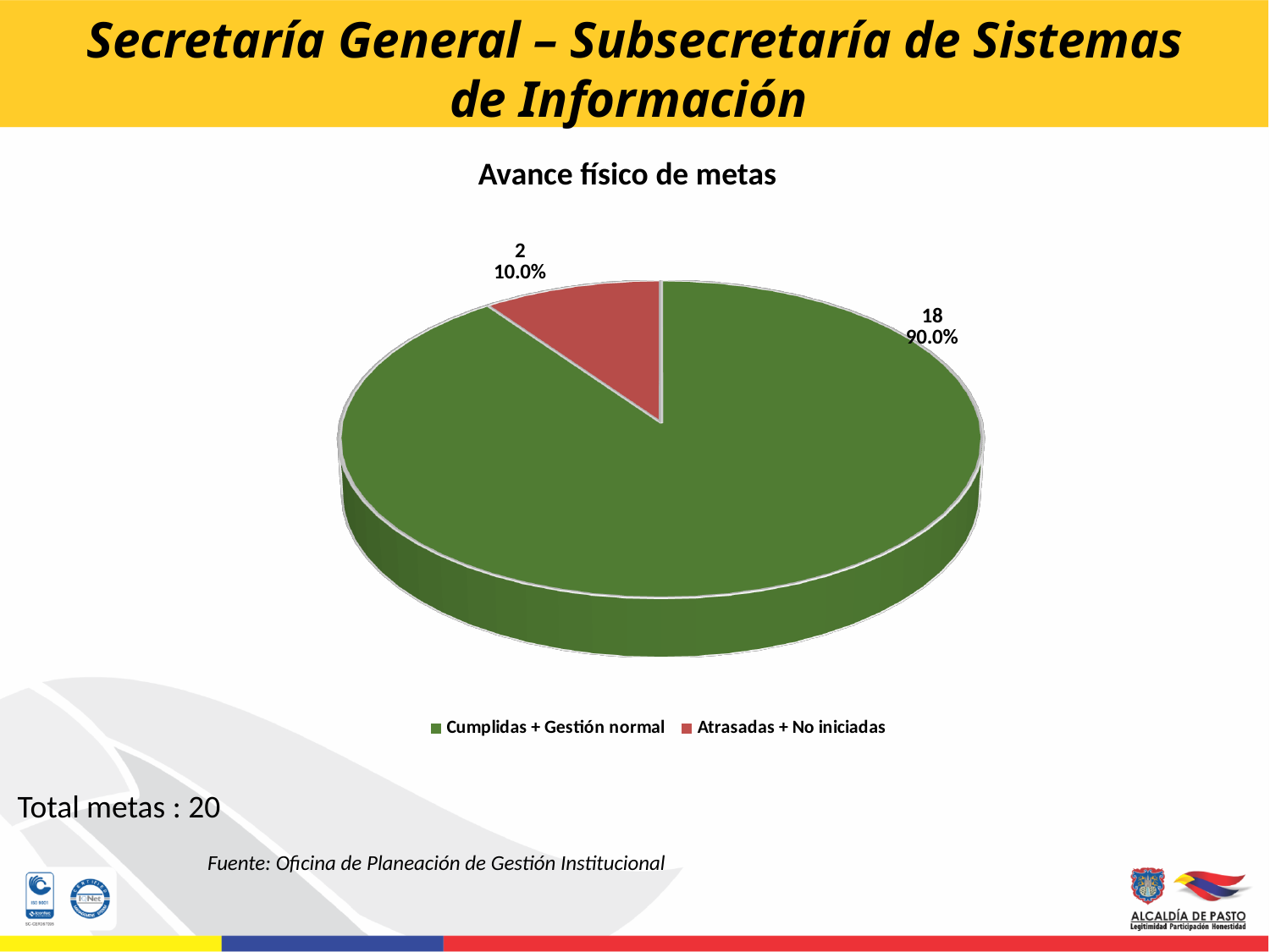
How many entries does the legend list? 2 What is the title of the chart? Avance físico de metas What type of chart is shown on the slide? Pie chart What is the difference between the values for Cumplidas + Gestión normal and Atrasadas + No iniciadas? 16 What share of the pie does Atrasadas + No iniciadas represent? 10.0% What is the value for Atrasadas + No iniciadas? 2 What share of the pie does Cumplidas + Gestión normal represent? 90.0% What is the value for Cumplidas + Gestión normal? 18 What colour is the slice for Atrasadas + No iniciadas? Red Which category has the smallest slice? Atrasadas + No iniciadas How many slices does the pie chart have? 2 Which category has the largest slice? Cumplidas + Gestión normal